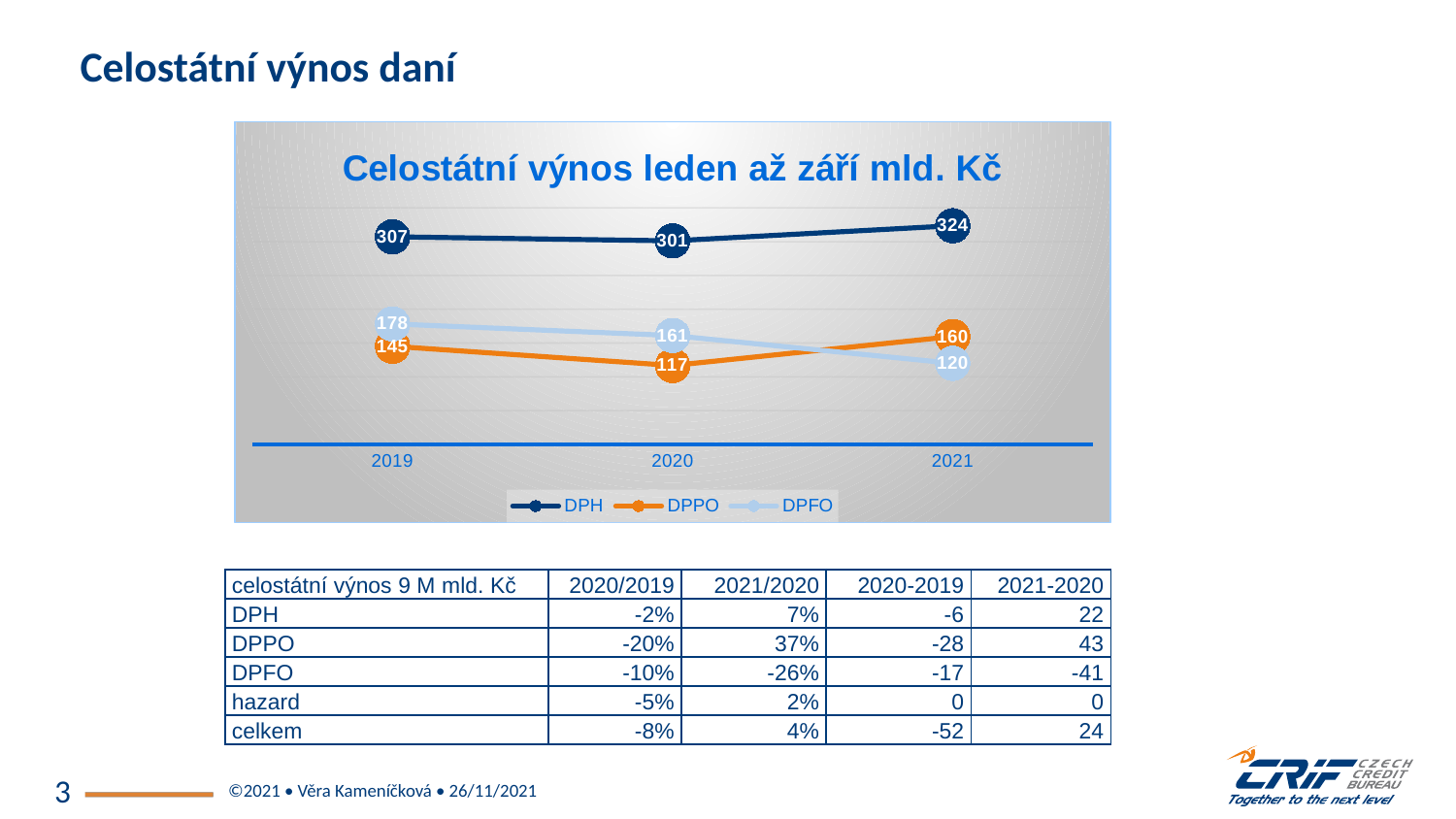
What is the value for DPFO in 2019? 178 What type of chart is shown on the slide? line chart How many series does the chart legend list? 3 What is the value for DPPO in 2020? 117 What is the title of the chart? Celostátní výnos leden až září mld. Kč Which is larger in 2021, DPPO or DPFO? DPPO How many years are shown on the x axis of the chart? 3 In which year is the DPPO value lowest? 2020 Does the DPFO series rise or fall from 2019 to 2021? fall What is the difference between the DPH value in 2021 and in 2020? 23 What is the value for DPH in 2021? 324 In which year is the DPH value highest? 2021